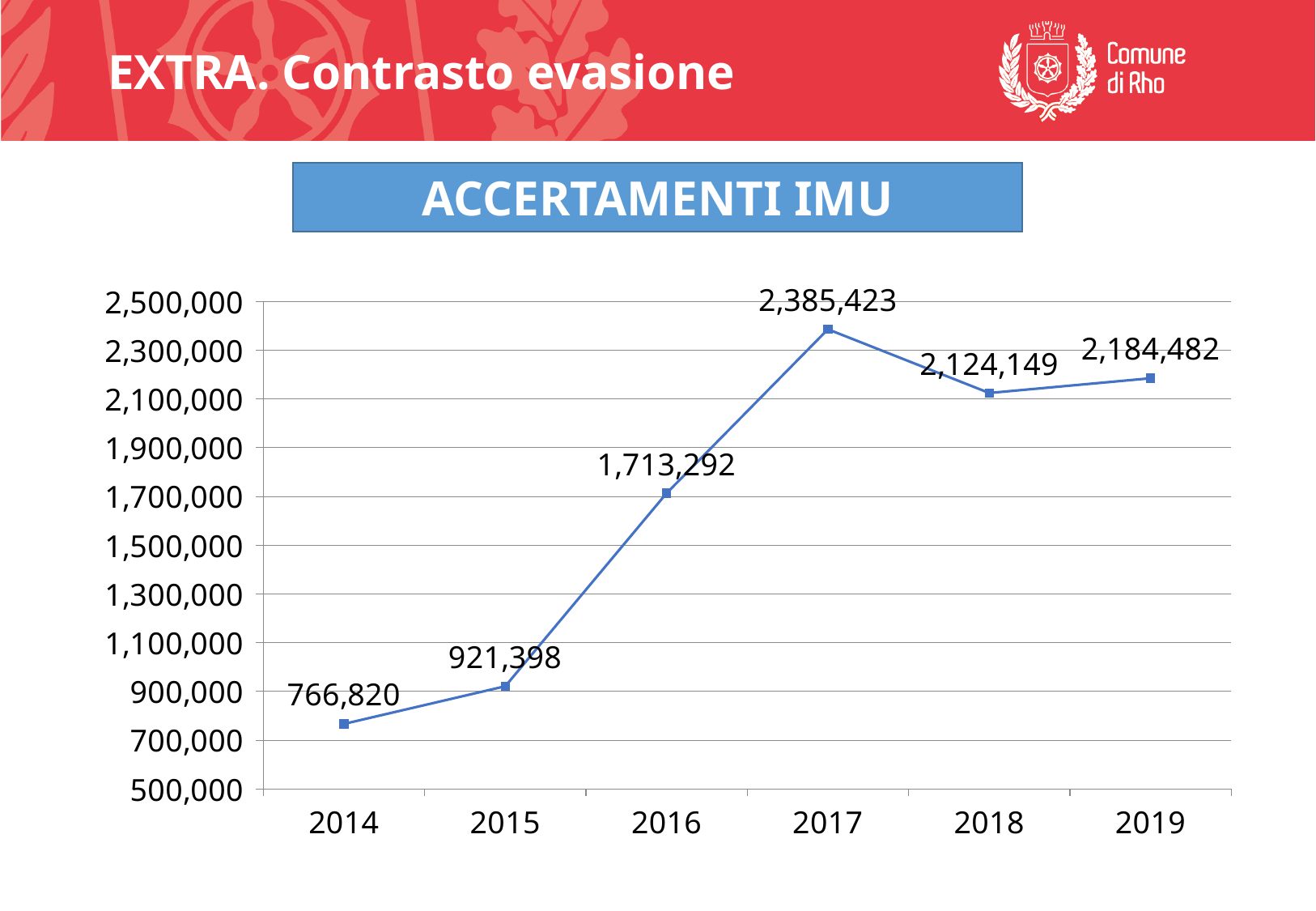
What kind of chart is the ACCERTAMENTI IMU chart? line chart How many years are plotted in the ACCERTAMENTI IMU chart? 6 Which year has the highest value in the ACCERTAMENTI IMU chart? 2017 Do the values in the ACCERTAMENTI IMU chart rise or fall from 2014 to 2017? rise Which year has the lowest value in the ACCERTAMENTI IMU chart? 2014 What is the value for 2014 in the ACCERTAMENTI IMU chart? 766,820 What is the value for 2017 in the ACCERTAMENTI IMU chart? 2,385,423 What is the difference between the 2019 and 2018 values in the ACCERTAMENTI IMU chart? 60,333 What is the difference between the 2017 and 2016 values in the ACCERTAMENTI IMU chart? 672,131 Which year has the larger value in the ACCERTAMENTI IMU chart, 2018 or 2019? 2019 What is the value for 2019 in the ACCERTAMENTI IMU chart? 2,184,482 Is the value for 2016 in the ACCERTAMENTI IMU chart greater or less than 1,500,000? greater